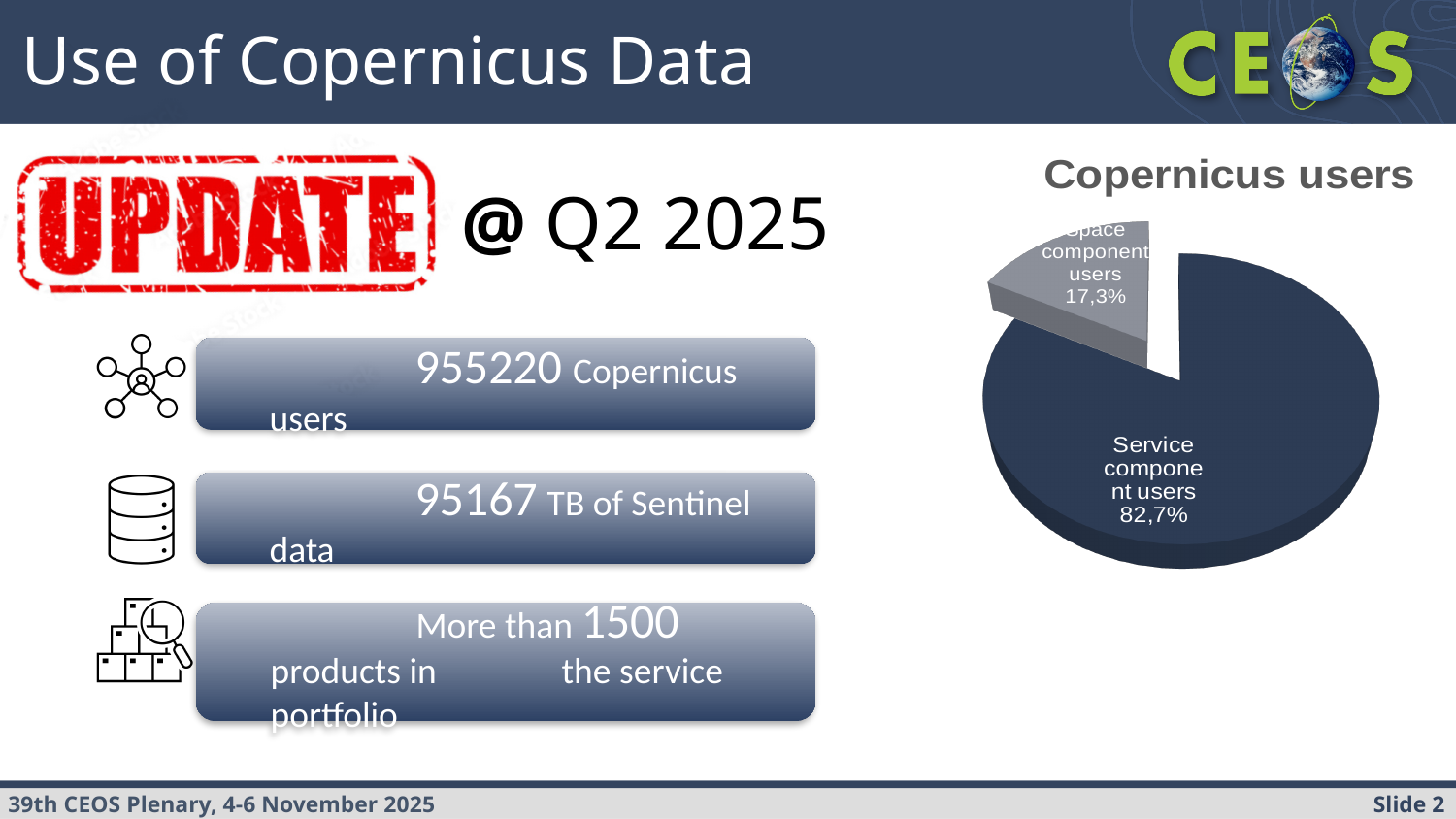
Which slice of the pie chart is the largest? Service component users What is the difference in percentage points between the Service component users share and the Space component users share? 65,4 Is the share of Space component users greater or less than 20%? less Which is larger: the share of Service component users or the share of Space component users? Service component users What share of the pie do Space component users represent? 17,3% Which slice of the pie chart is the smallest? Space component users What share of the pie do Service component users represent? 82,7% What is the title of the pie chart? Copernicus users How many slices does the pie chart have? 2 Is the share of Service component users greater or less than 80%? greater What kind of chart is shown on the slide? Pie chart